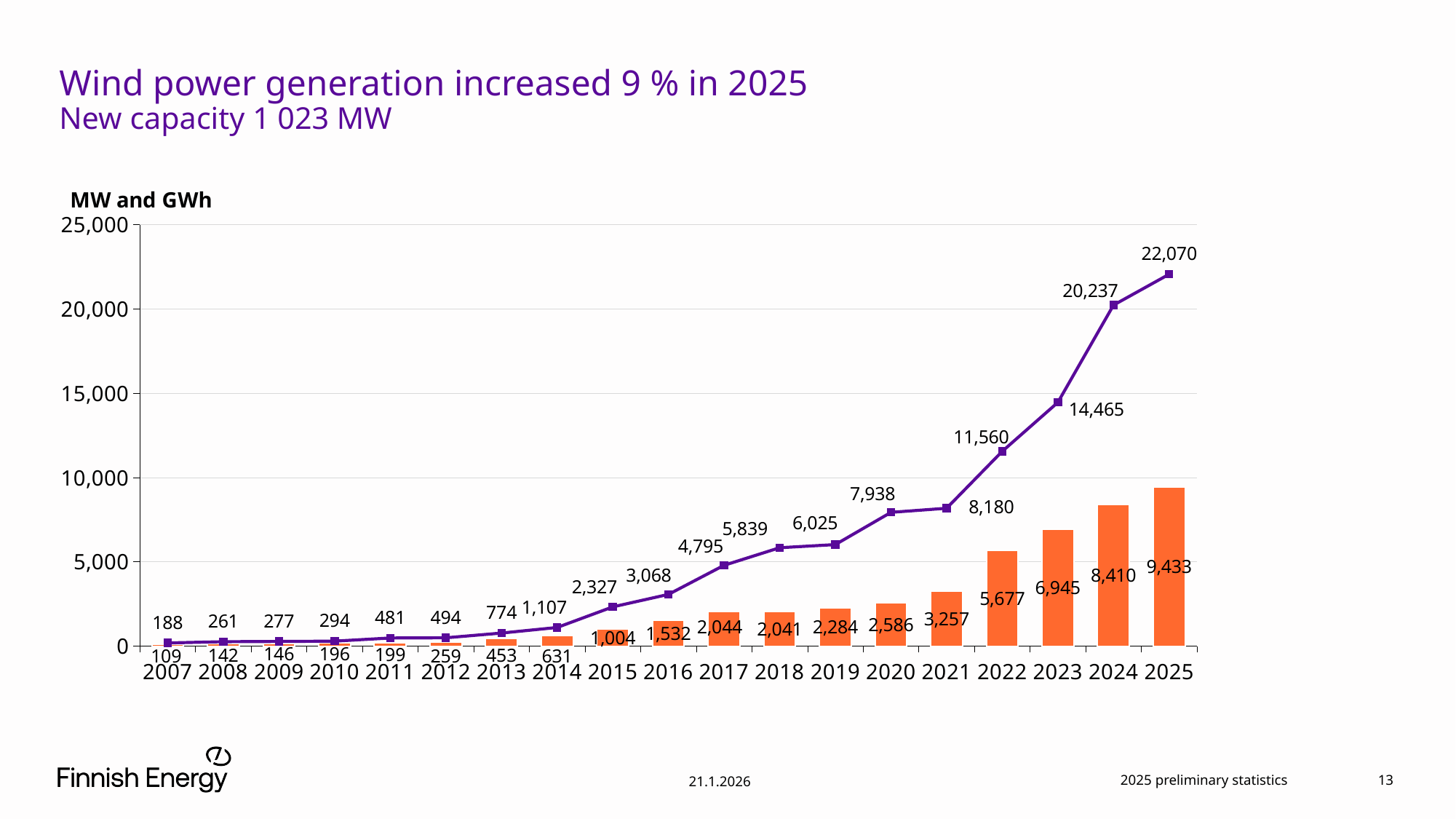
How many years are shown on the x axis? 19 Which is larger, the purple line value for 2022 or the orange bar value for 2022? The purple line value (11,560) Which year has the highest value on the purple line? 2025 What is the value of the orange bar for 2018? 2,041 What does the label above the y axis say? MW and GWh What is the difference between the purple line values for 2025 and 2024? 1,833 Which year has the lowest value for the orange bars? 2007 What is the value of the purple line for 2024? 20,237 What is the value of the orange bar for 2025? 9,433 What is the value of the purple line for 2013? 774 What is the difference between the orange bar values for 2025 and 2024? 1,023 Is the purple line value for 2023 greater or less than 10,000? greater